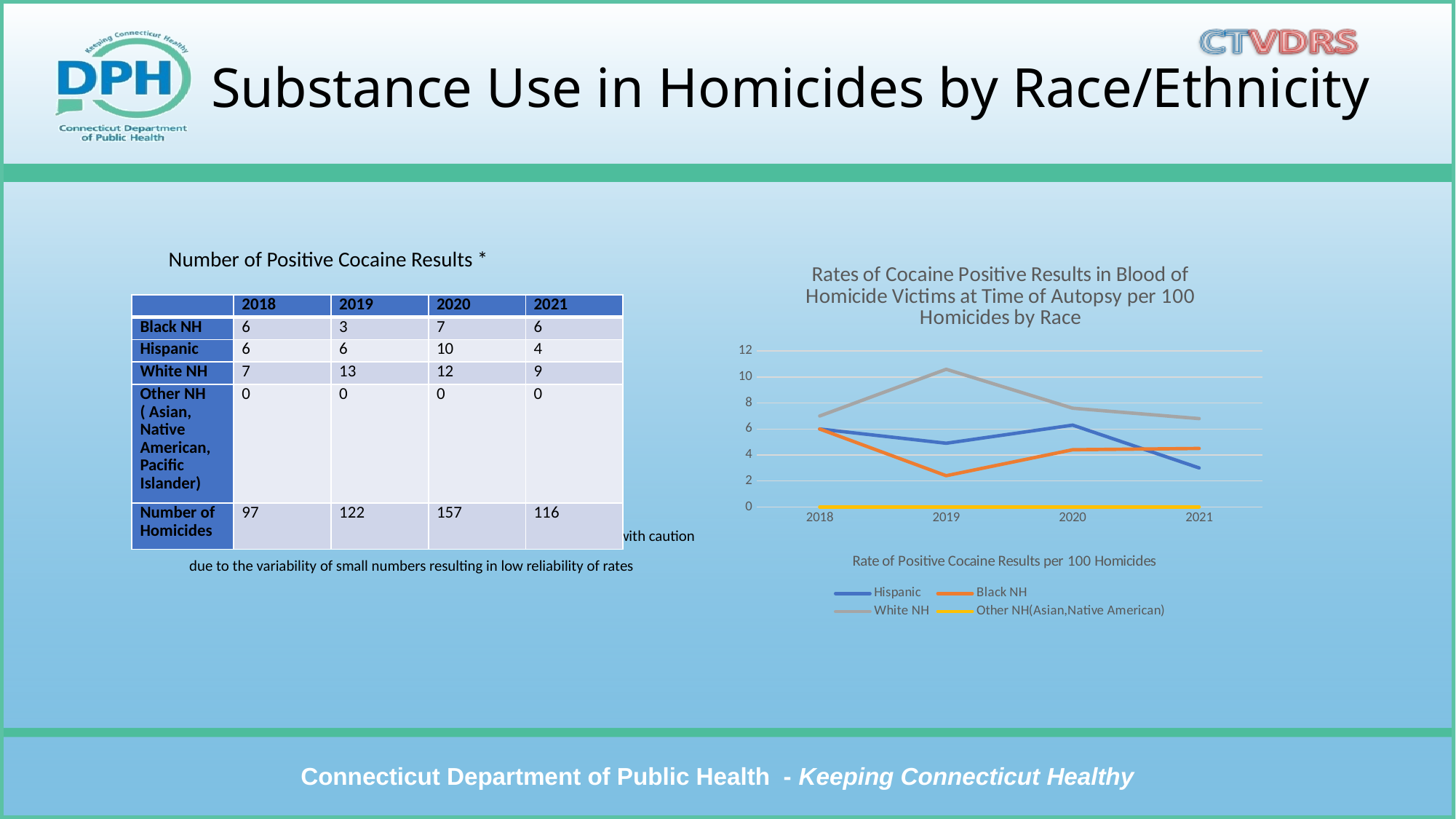
In the line chart, which series has the lowest value in 2019? Other NH(Asian,Native American) What colour is the Other NH(Asian,Native American) line in the line chart? yellow In the line chart, which is larger in 2021, the value for Hispanic or the value for Black NH? Black NH How many series does the legend of the line chart list? 4 In the line chart, what is the value for Other NH(Asian,Native American) in 2020? 0 What kind of chart is shown on the right side of the slide? line chart In the line chart, does the White NH line rise or fall from 2018 to 2019? rise In the line chart, does the Hispanic line rise or fall from 2020 to 2021? fall In the line chart, is the value for White NH in 2019 greater or less than 10? greater How many years are shown on the x axis of the line chart? 4 In the line chart, which series has the highest value in 2019? White NH In the line chart, is the value for Black NH in 2019 greater or less than 4? less